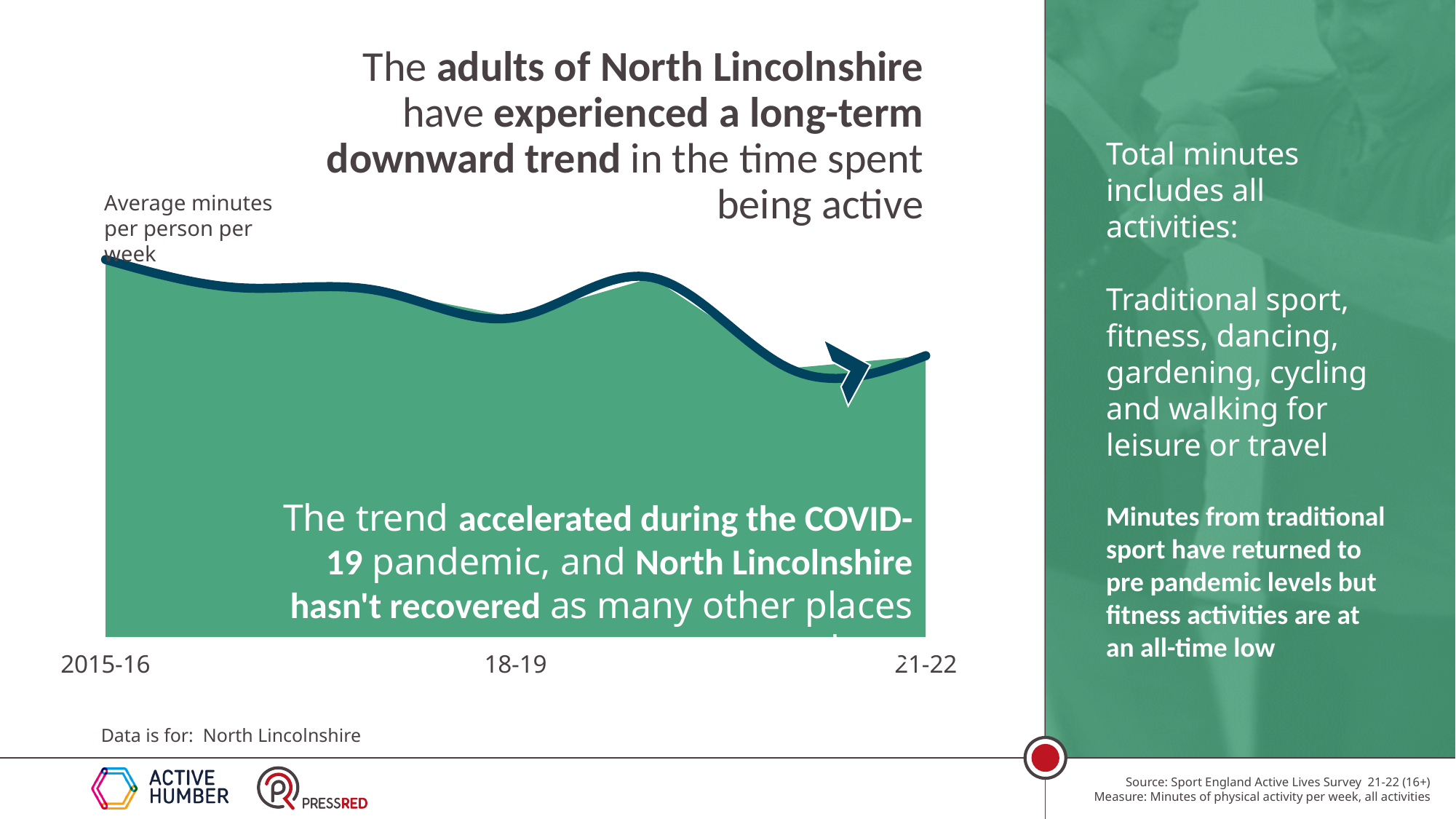
What is the first year label shown on the x axis of the chart? 2015-16 Of the years labelled on the x axis, which has the highest value in the chart? 2015-16 What is the last year label shown on the x axis of the chart? 21-22 Overall, do the values in the chart rise or fall from 2015-16 to 21-22? Fall Which is higher in the chart, the value for 2015-16 or the value for 21-22? 2015-16 What does the y axis of the chart measure, according to the label at the top left of the chart? Average minutes per person per week Of the years labelled on the x axis, which has the lowest value in the chart? 21-22 Which is higher in the chart, the value for 18-19 or the value for 21-22? 18-19 How many year labels are printed along the x axis of the chart? 3 According to the slide, during which event did the downward trend accelerate? The COVID-19 pandemic Which area is the chart's data for, according to the note below the chart? North Lincolnshire What kind of chart is shown on the slide? Area chart